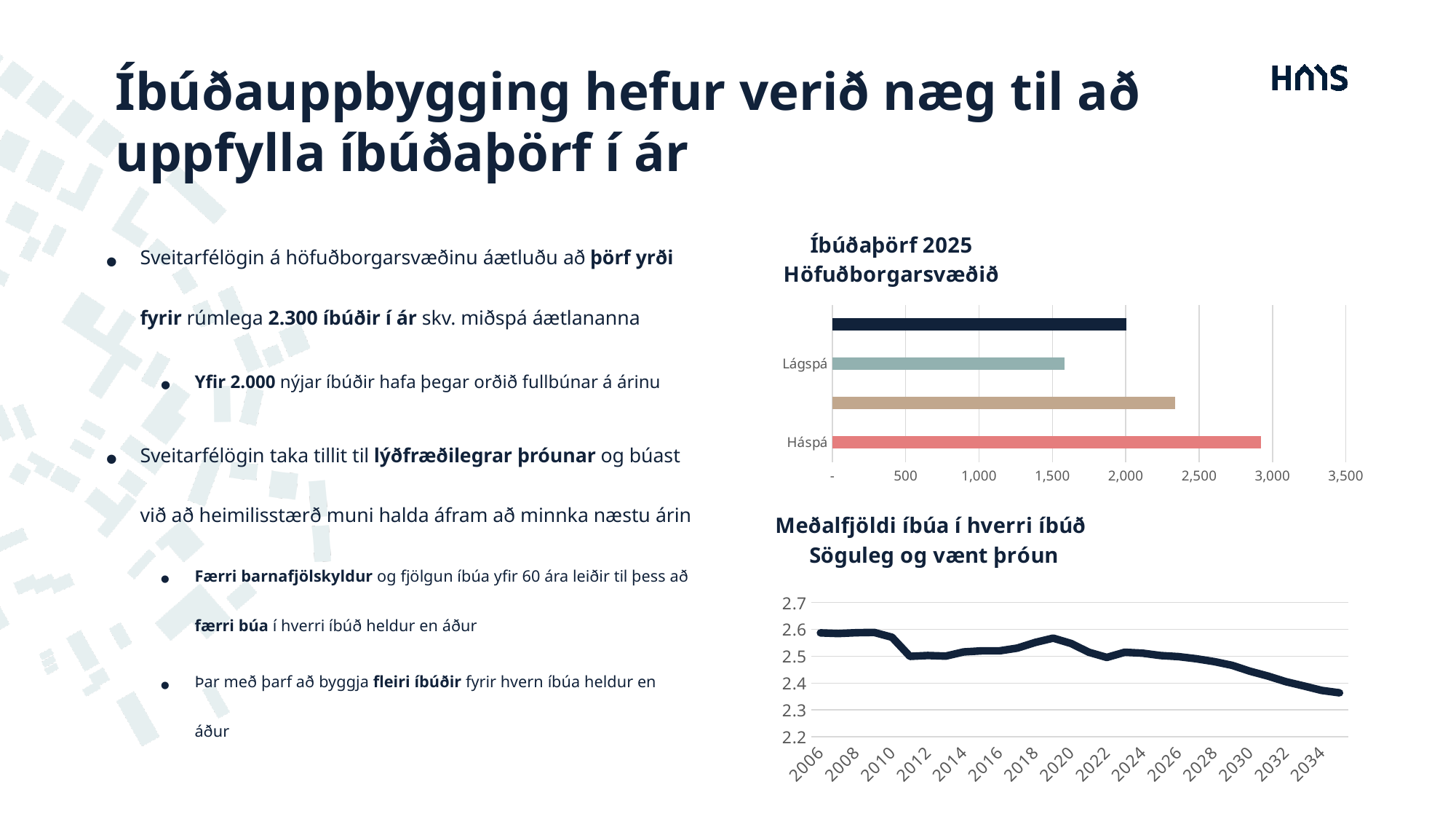
In the 'Íbúðaþörf 2025 Höfuðborgarsvæðið' chart, which is larger, Háspá or Lágspá? Háspá What is the highest tick value shown on the x axis of the 'Íbúðaþörf 2025 Höfuðborgarsvæðið' chart? 3,500 How many bars are shown in the 'Íbúðaþörf 2025 Höfuðborgarsvæðið' chart? 4 In the 'Íbúðaþörf 2025 Höfuðborgarsvæðið' chart, which bar is the longest? Háspá In the 'Íbúðaþörf 2025 Höfuðborgarsvæðið' chart, is the value for Háspá greater or less than 2,500? greater What is the subtitle shown under 'Meðalfjöldi íbúa í hverri íbúð' on the line chart? Söguleg og vænt þróun In the 'Meðalfjöldi íbúa í hverri íbúð' chart, is the value for 2034 greater or less than 2.5? less In the 'Meðalfjöldi íbúa í hverri íbúð' chart, do the values generally rise or fall from 2006 to 2034? fall In the 'Meðalfjöldi íbúa í hverri íbúð' chart, is the value for 2006 greater or less than 2.5? greater What kind of chart is the 'Íbúðaþörf 2025 Höfuðborgarsvæðið' chart? bar chart What kind of chart is the 'Meðalfjöldi íbúa í hverri íbúð' chart? line chart